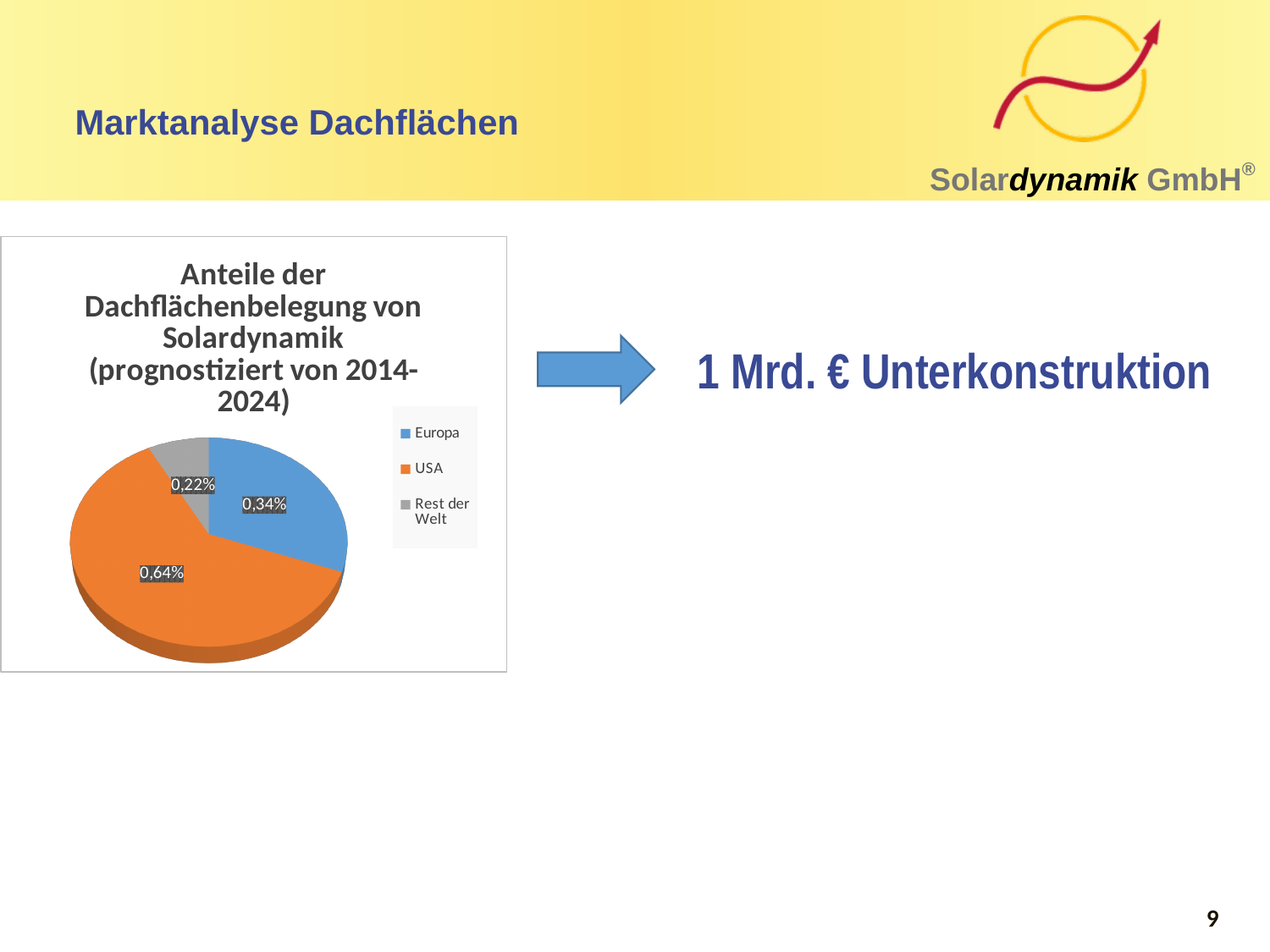
Which category has the largest slice in the pie chart? USA How many entries does the legend of the pie chart list? 3 What value is labelled on the Rest der Welt slice of the pie chart? 0,22% What is the title of the pie chart? Anteile der Dachflächenbelegung von Solardynamik (prognostiziert von 2014-2024) Which slice is larger in the pie chart, Europa or Rest der Welt? Europa Which category has the smallest slice in the pie chart? Rest der Welt What value is labelled on the Europa slice of the pie chart? 0,34% What type of chart is shown on the slide? Pie chart What is the difference between the labelled values for USA and Europa in the pie chart? 0,30% What value is labelled on the USA slice of the pie chart? 0,64% What colour is the USA slice in the pie chart? Orange How many slices does the pie chart have? 3